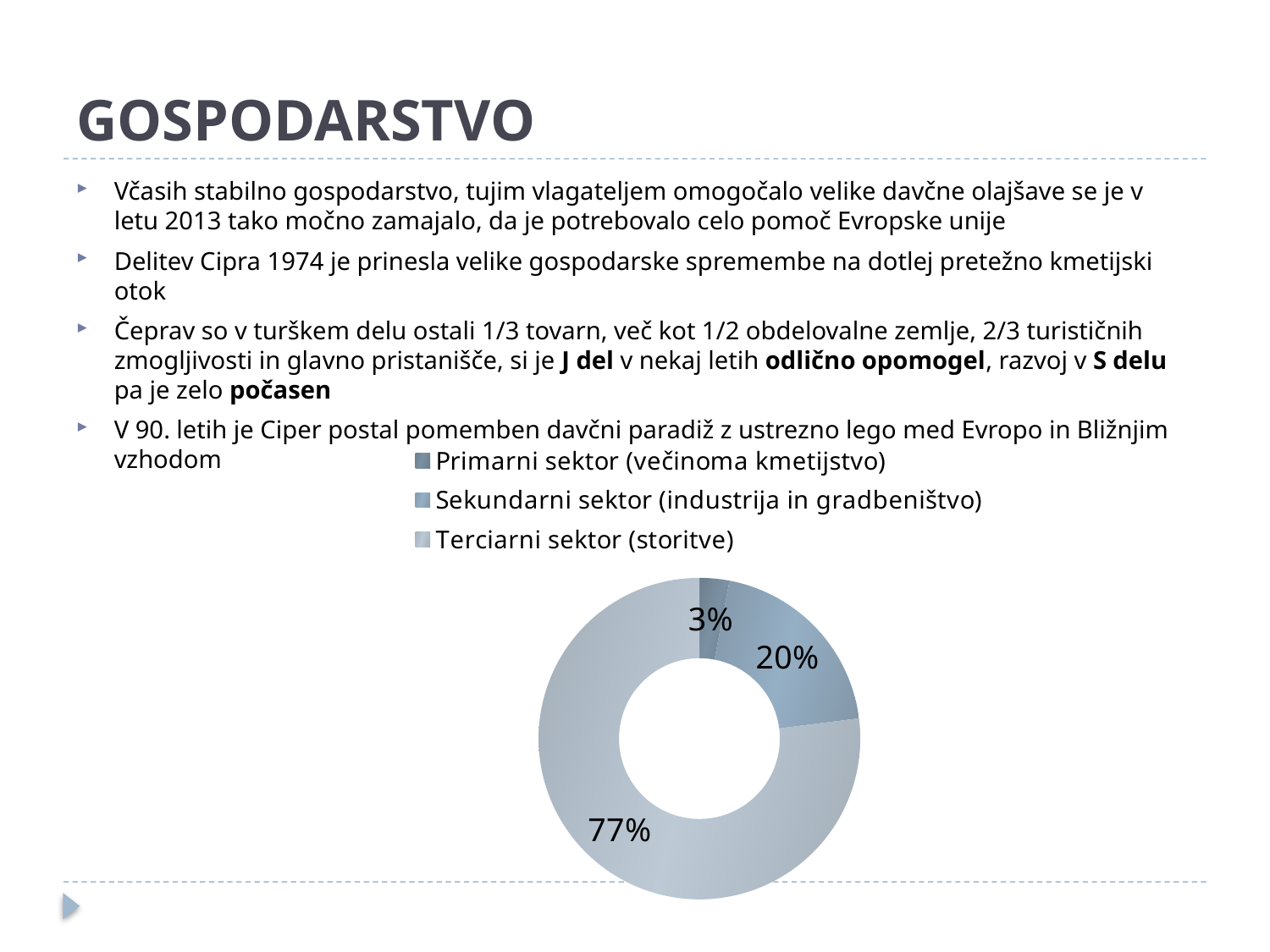
Which sector has the smallest share in the doughnut chart? Primarni sektor (večinoma kmetijstvo) What is the difference in percentage points between the Terciarni sektor and the Sekundarni sektor shares? 57 Which legend entry is listed first in the chart legend? Primarni sektor (večinoma kmetijstvo) How many entries does the chart legend list? 3 What share of the doughnut chart does Terciarni sektor (storitve) have? 77% How many slices does the doughnut chart have? 3 What share of the doughnut chart does Sekundarni sektor (industrija in gradbeništvo) have? 20% Which sector has the largest share in the doughnut chart? Terciarni sektor (storitve) Which has a larger share, Sekundarni sektor or Primarni sektor? Sekundarni sektor What kind of chart is shown on the slide? Doughnut chart What is the difference in percentage points between the Sekundarni sektor and the Primarni sektor shares? 17 What share of the doughnut chart does Primarni sektor (večinoma kmetijstvo) have? 3%